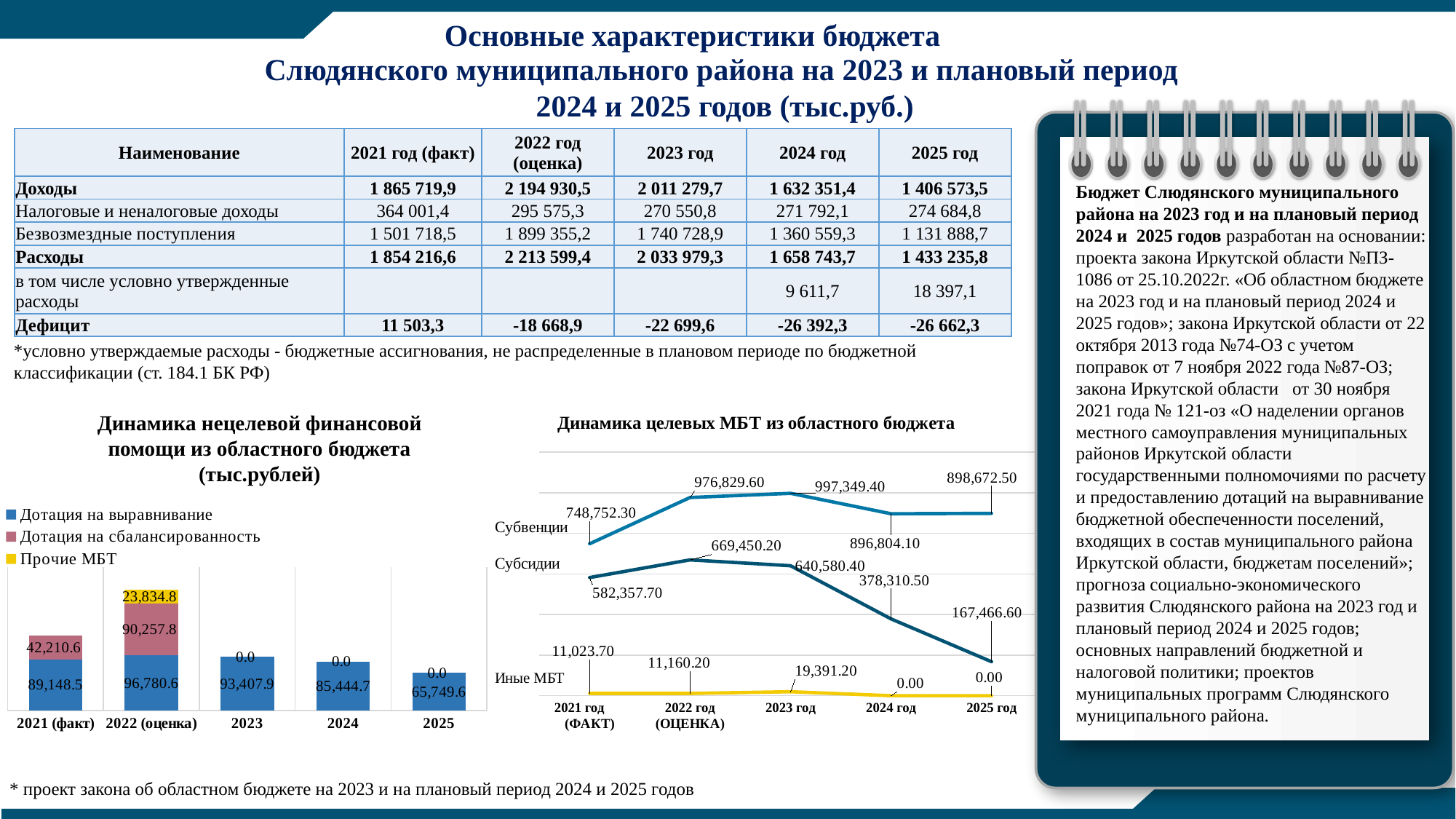
In the chart 'Динамика целевых МБТ из областного бюджета', what is the value of 'Субсидии' for 2025 год? 167,466.60 In the chart 'Динамика нецелевой финансовой помощи из областного бюджета', what is the value of 'Дотация на сбалансированность' for 2021 (факт)? 42,210.6 In the chart 'Динамика целевых МБТ из областного бюджета', which year has the highest value of 'Субвенции'? 2023 год In the chart 'Динамика нецелевой финансовой помощи из областного бюджета', what is the total of the stacked bar for 2022 (оценка)? 210,873.2 In the chart 'Динамика нецелевой финансовой помощи из областного бюджета', how many series does the legend list? 3 What kind of chart is 'Динамика нецелевой финансовой помощи из областного бюджета (тыс.рублей)'? Stacked bar chart In the chart 'Динамика целевых МБТ из областного бюджета', what is the difference between 'Субвенции' in 2023 год and 2022 год (ОЦЕНКА)? 20,519.80 In the chart 'Динамика целевых МБТ из областного бюджета', what is the value of 'Субвенции' for 2024 год? 896,804.10 In the chart 'Динамика нецелевой финансовой помощи из областного бюджета', what is the value of 'Дотация на выравнивание' for 2023? 93,407.9 In the chart 'Динамика нецелевой финансовой помощи из областного бюджета', which year has the lowest value of 'Дотация на выравнивание'? 2025 In the chart 'Динамика целевых МБТ из областного бюджета', do the values of 'Субсидии' rise or fall from 2023 год to 2025 год? Fall What kind of chart is 'Динамика целевых МБТ из областного бюджета'? Line chart